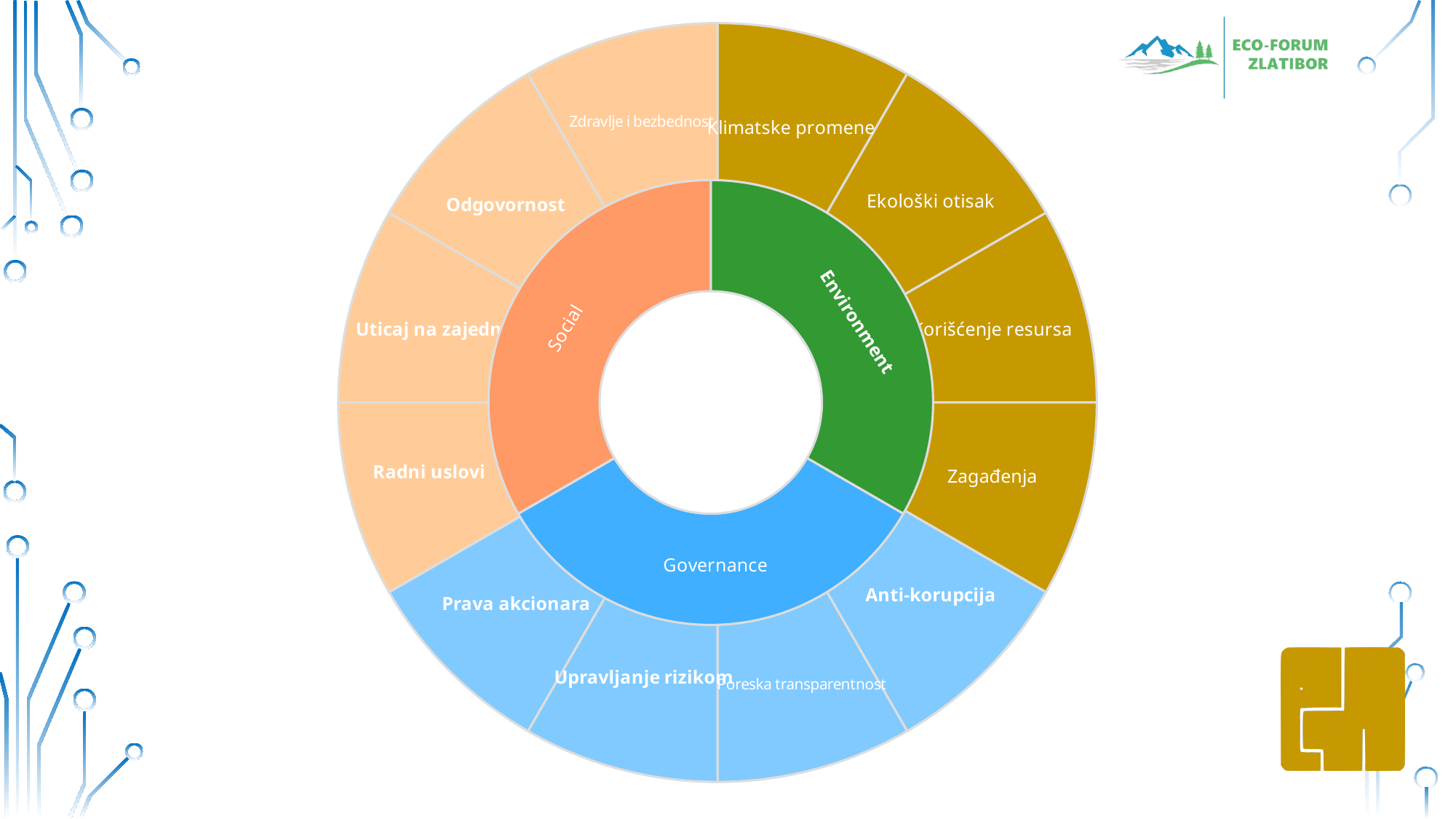
Which inner-ring category does the segment 'Anti-korupcija' belong to? Governance How many categories are in the inner ring of the chart? 3 How many outer-ring segments belong to the Social category? 4 What kind of chart is shown on the slide? Doughnut chart What are the three inner-ring categories of the chart? Social, Environment, Governance What colour is the Governance segment in the inner ring? Blue How many outer-ring segments belong to the Governance category? 4 Which inner-ring category does the segment 'Zagađenja' belong to? Environment Which inner-ring category does the segment 'Radni uslovi' belong to? Social